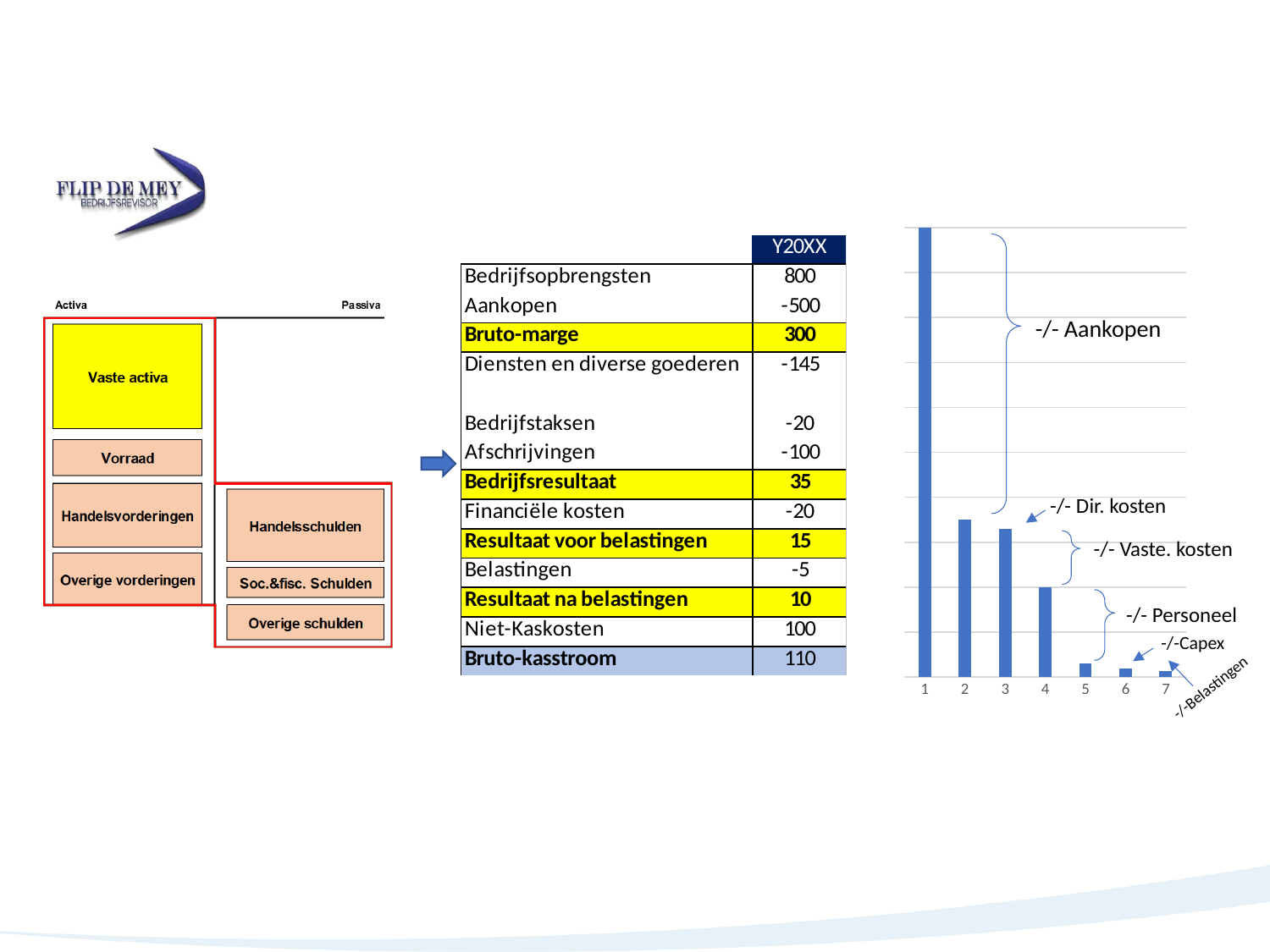
In the bar chart on the right, which bar is taller, category 1 or category 2? 1 In the bar chart on the right, what label is written next to the bracket between bar 4 and bar 5? -/- Personeel How many bars are plotted in the bar chart on the right? 7 In the bar chart on the right, what label is written next to the bracket between bar 1 and bar 2? -/- Aankopen In the bar chart on the right, which bar is taller, category 3 or category 5? 3 In the bar chart on the right, do the bar heights rise or fall from category 1 to category 7? fall In the bar chart on the right, which bar is taller, category 2 or category 4? 2 Which category has the tallest bar in the bar chart on the right? 1 What kind of chart is shown on the right side of the slide? bar chart